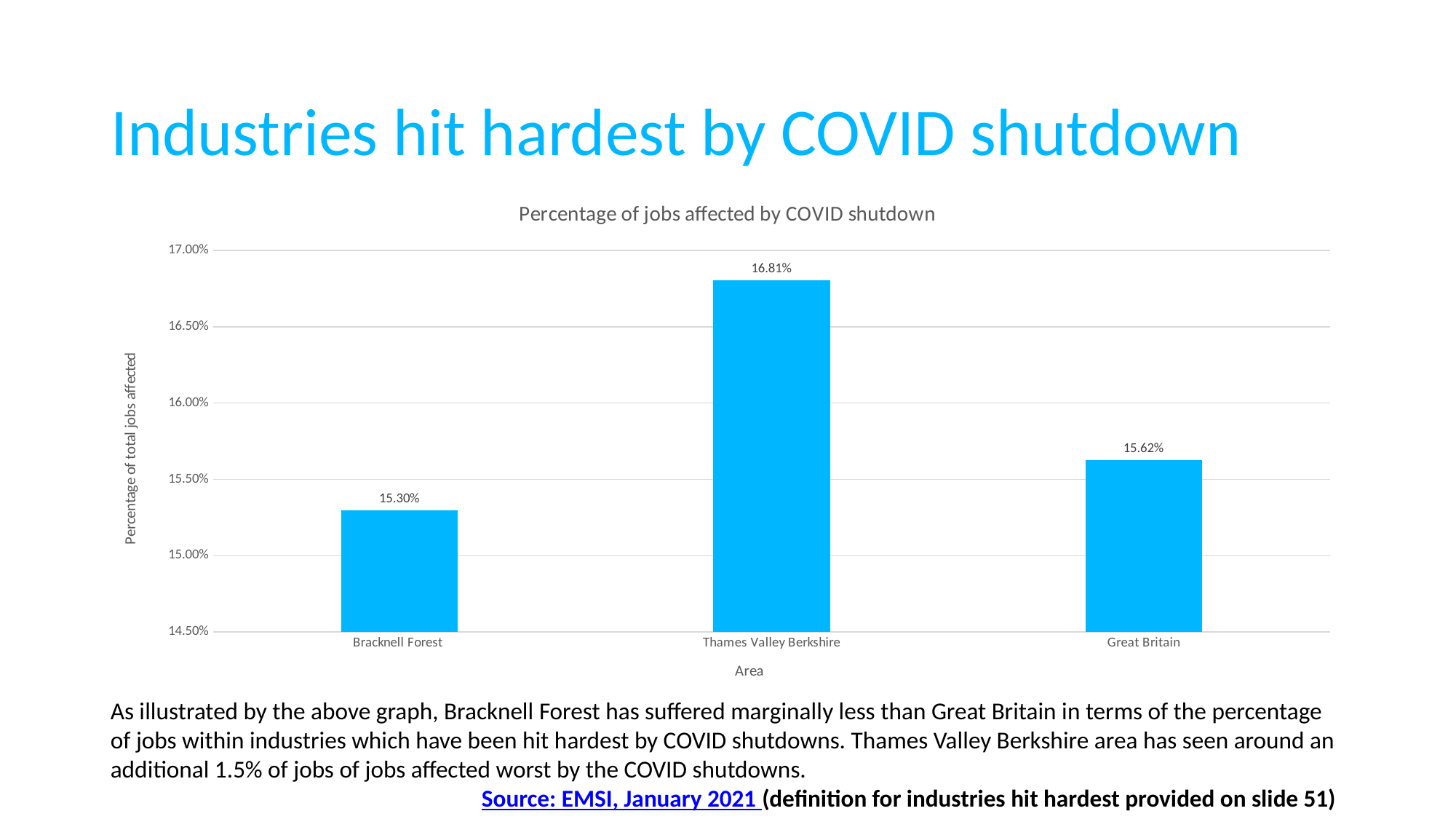
Which area has the highest percentage of jobs affected by COVID shutdown? Thames Valley Berkshire What is the title of the chart? Percentage of jobs affected by COVID shutdown What is the percentage of jobs affected by COVID shutdown for Bracknell Forest? 15.30% What is the percentage of jobs affected by COVID shutdown for Thames Valley Berkshire? 16.81% What is the difference in percentage points between Thames Valley Berkshire and Bracknell Forest? 1.51% What is the percentage of jobs affected by COVID shutdown for Great Britain? 15.62% How many areas are shown on the chart? 3 Is the value for Thames Valley Berkshire greater or less than 16.50%? greater What is the difference in percentage points between Great Britain and Bracknell Forest? 0.32% Which has a higher percentage of jobs affected, Great Britain or Bracknell Forest? Great Britain Which area has the lowest percentage of jobs affected by COVID shutdown? Bracknell Forest What type of chart is used to show the percentage of jobs affected by COVID shutdown? Bar chart